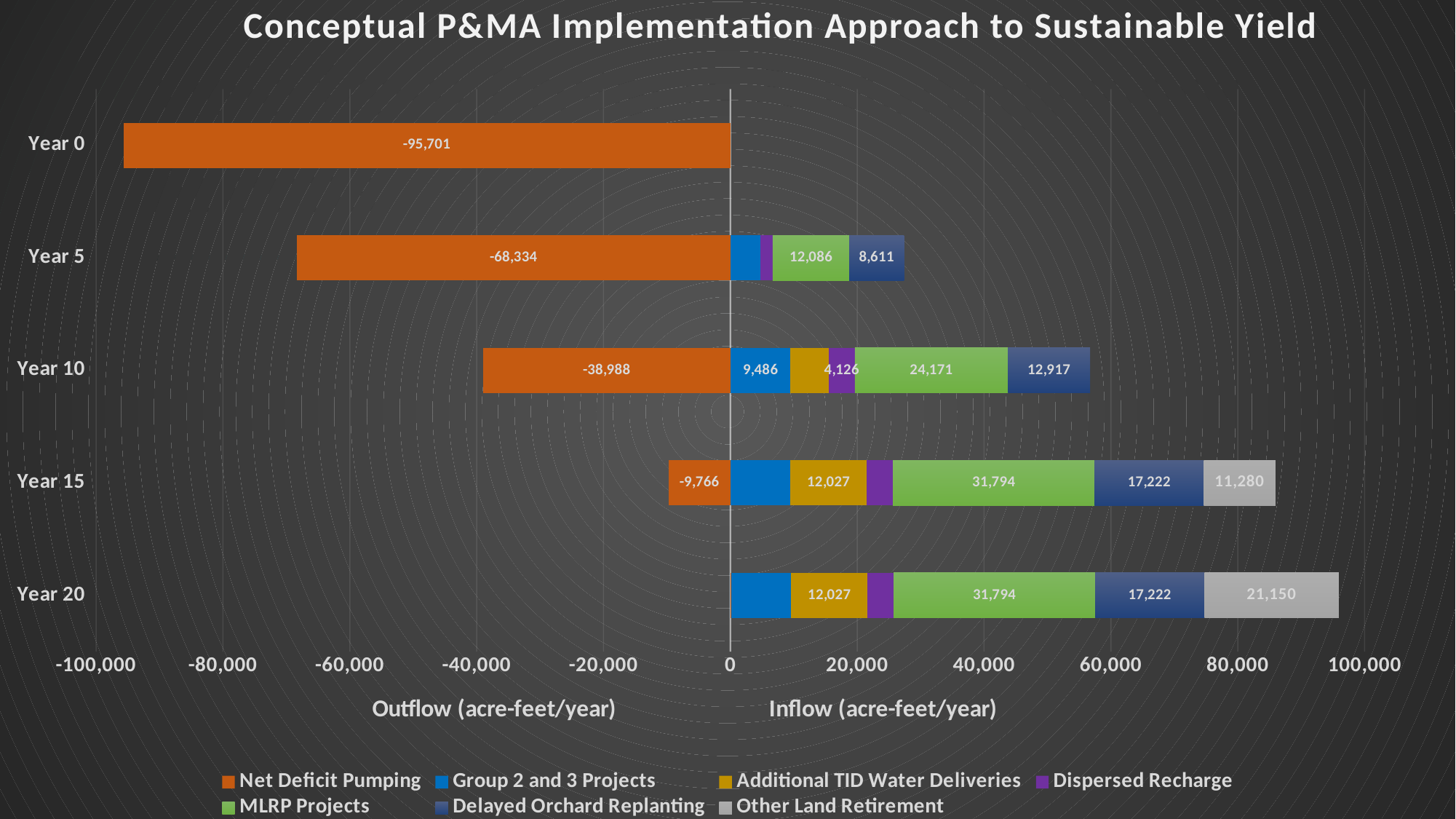
How many year categories are plotted on the chart? 5 Which year has the larger Delayed Orchard Replanting value, Year 5 or Year 10? Year 10 What is the MLRP Projects value for Year 10? 24,171 How many series does the legend list? 7 What is the Net Deficit Pumping value for Year 0? -95,701 Which year has the largest Net Deficit Pumping outflow? Year 0 What is the Additional TID Water Deliveries value for Year 15? 12,027 What is the Other Land Retirement value for Year 20? 21,150 What is the Delayed Orchard Replanting value for Year 5? 8,611 How much larger is the Other Land Retirement value in Year 20 than in Year 15? 9,870 What kind of chart is shown on the slide? bar chart What is the difference between the MLRP Projects values for Year 15 and Year 10? 7,623